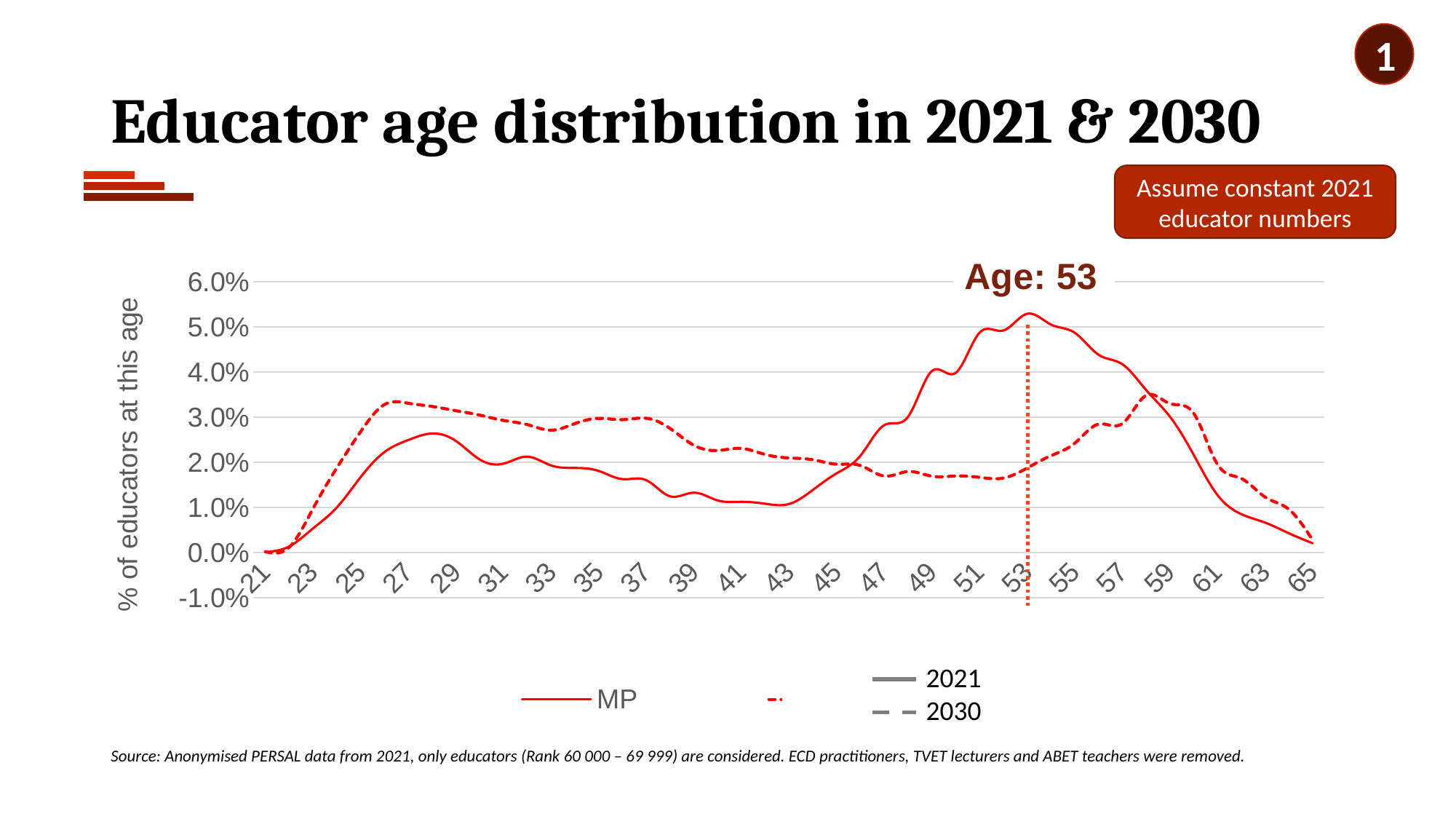
At age 27, which line is higher: the solid 2021 line or the dashed 2030 line? 2030 Is the value of the dashed 2030 line at age 27 greater or less than 3.0%? greater Is the value of the solid 2021 line at age 43 greater or less than 2.0%? less Between ages 21 and 27, does the dashed 2030 line rise or fall? rise At age 53, which line is higher: the solid 2021 line or the dashed 2030 line? 2021 What kind of chart is shown on the slide? line chart Between ages 53 and 65, does the solid 2021 line rise or fall? fall Which two years does the legend distinguish with solid and dashed lines? 2021 and 2030 Is the value of the solid 2021 line at age 21 greater or less than 1.0%? less What is the title of the vertical axis? % of educators at this age At which age does the solid 2021 line reach its highest value? 53